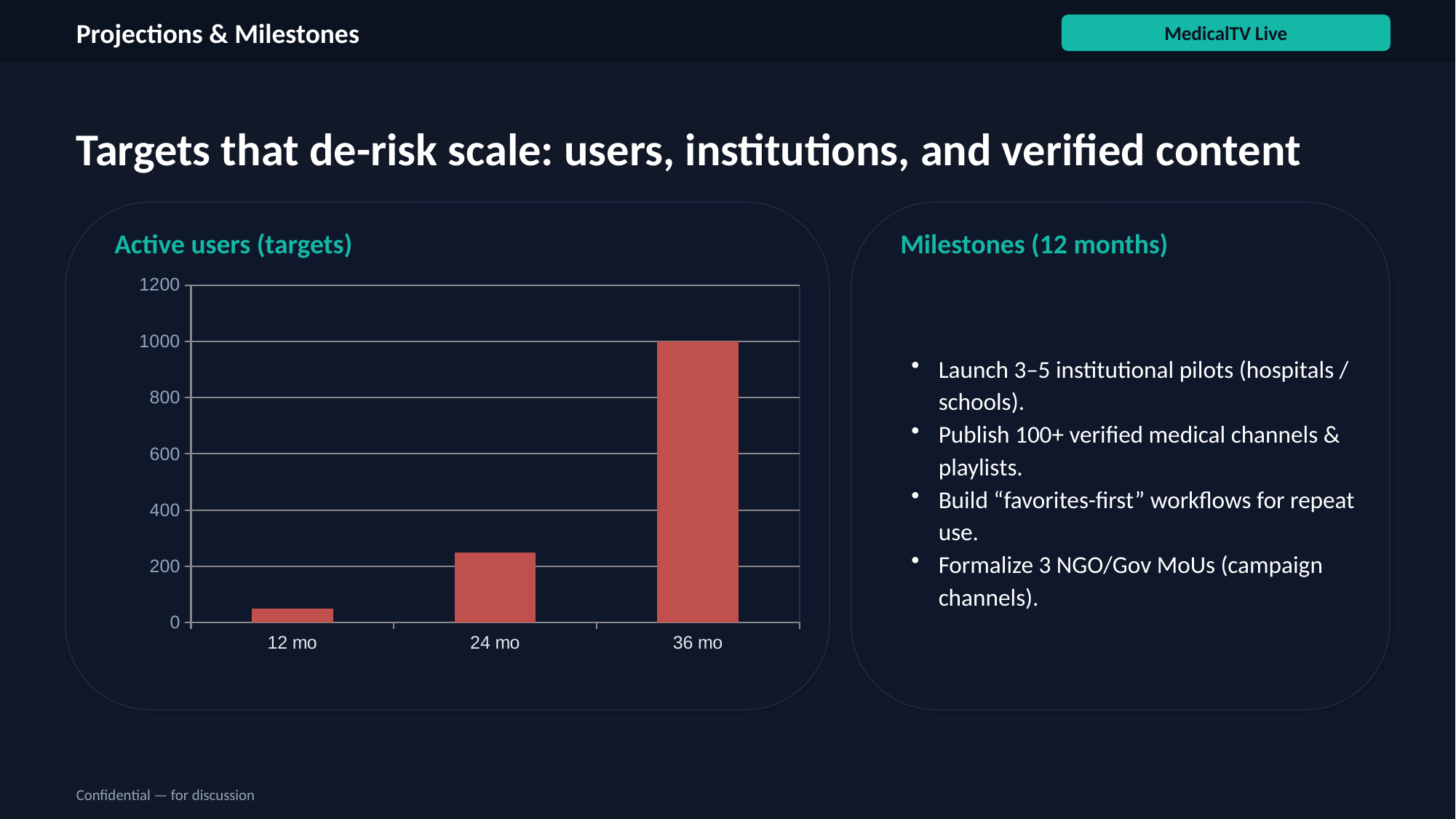
How many categories are shown on the x axis of the Active users (targets) chart? 3 What kind of chart is shown under "Active users (targets)"? bar chart Do the values in the Active users (targets) chart rise or fall from 12 mo to 36 mo? rise Which category has the highest value in the Active users (targets) chart? 36 mo Which category has the lowest value in the Active users (targets) chart? 12 mo In the Active users (targets) chart, what is the value for 36 mo? 1000 Is the value for 24 mo in the Active users (targets) chart greater or less than 200? greater Is the value for 12 mo in the Active users (targets) chart greater or less than 200? less What is the title of the chart on the left of the slide? Active users (targets) Is the value for 24 mo in the Active users (targets) chart greater or less than 400? less In the Active users (targets) chart, which is larger: the value for 24 mo or the value for 12 mo? 24 mo